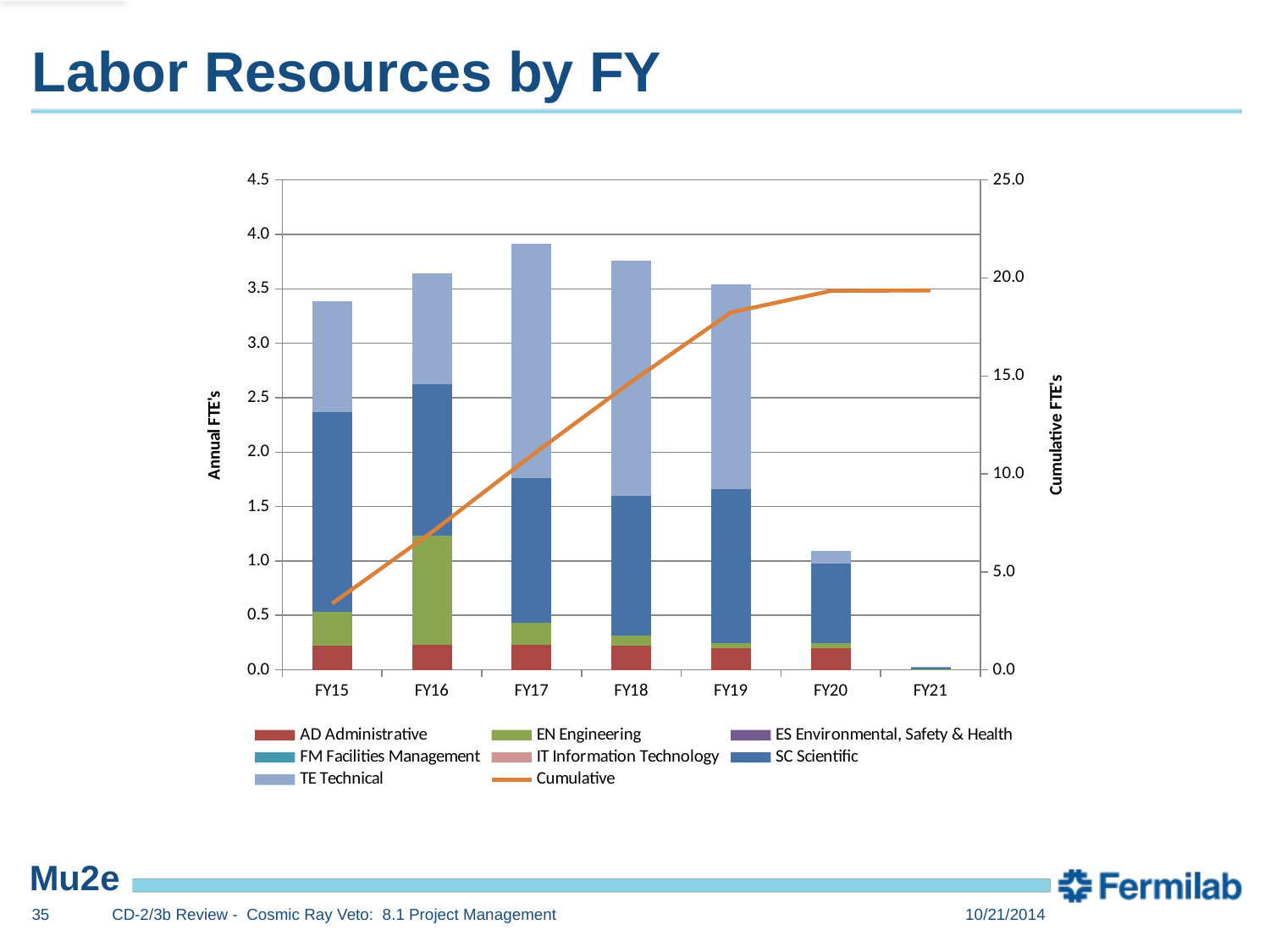
Is the Cumulative value at FY20 greater or less than 15.0? greater Is the total stacked bar for FY20 greater or less than 1.5 annual FTE's? less What is the title of the right-hand vertical axis? Cumulative FTE's Does the Cumulative line rise or fall from FY15 to FY19? rise Which has the taller stacked bar, FY16 or FY20? FY16 Is the Cumulative value at FY15 greater or less than 5.0? less What kind of chart is shown on the slide? Stacked bar chart with a cumulative line How many entries does the legend list? 8 How many fiscal years are shown on the x axis? 7 Which fiscal year has the tallest stacked bar? FY17 Which fiscal year has the shortest stacked bar? FY21